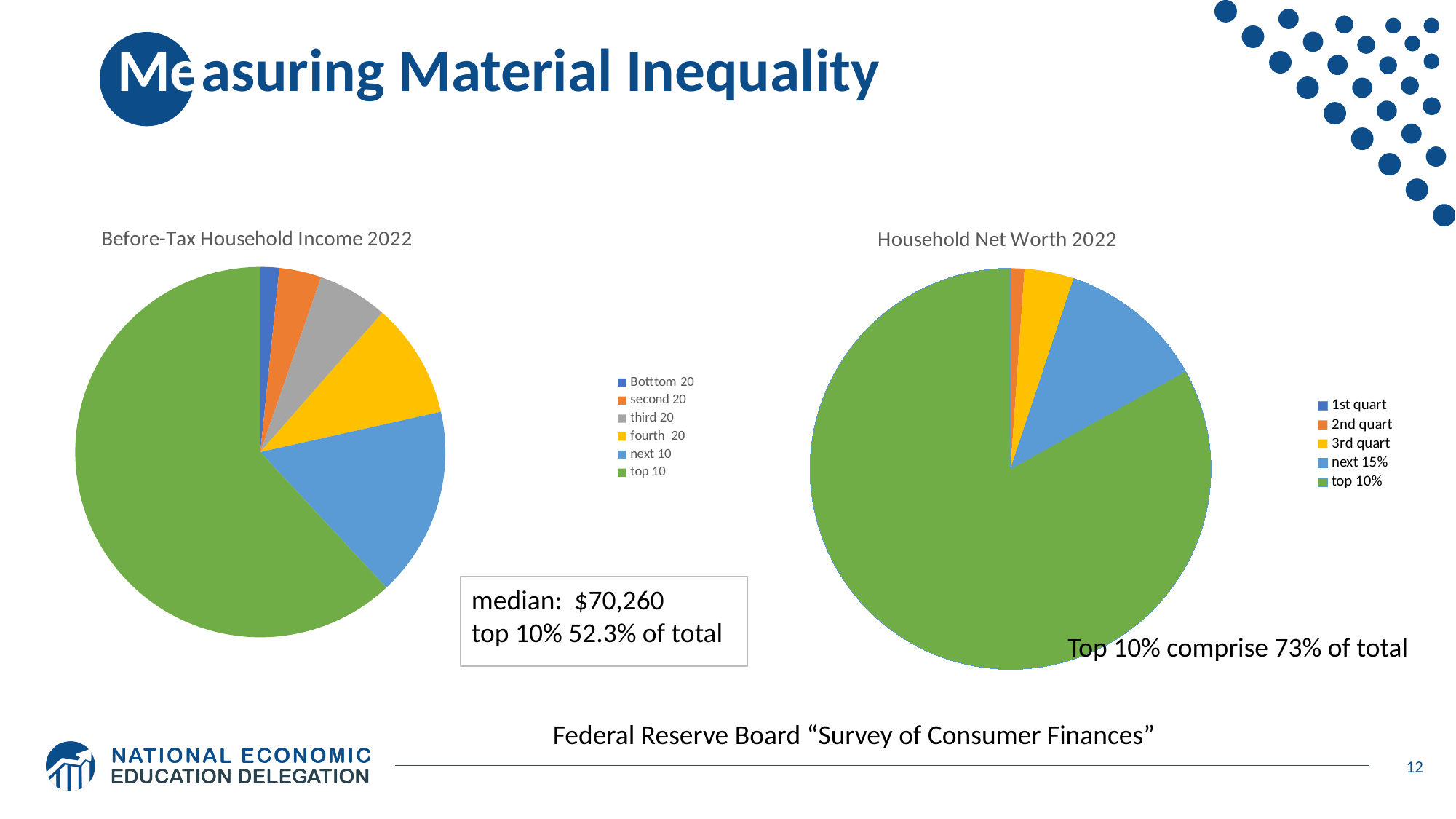
In the 'Before-Tax Household Income 2022' chart, what share of the total does the top 10% hold? 52.3% In the 'Household Net Worth 2022' chart, how many categories does the legend list? 5 In the 'Before-Tax Household Income 2022' chart, how many categories does the legend list? 6 In the 'Before-Tax Household Income 2022' chart, which slice is larger: 'fourth 20' or 'third 20'? fourth 20 What colour represents the 'top 10%' slice in the 'Household Net Worth 2022' chart? green What kind of chart is the 'Before-Tax Household Income 2022' chart? pie chart In the 'Before-Tax Household Income 2022' chart, which slice is larger: 'top 10' or 'next 10'? top 10 In the 'Household Net Worth 2022' chart, which category has the largest slice? top 10% In the 'Household Net Worth 2022' chart, what share of the total does the top 10% hold? 73% In the 'Before-Tax Household Income 2022' chart, which category has the largest slice? top 10 What is the median before-tax household income stated on the slide? $70,260 In the 'Household Net Worth 2022' chart, which slice is larger: 'next 15%' or '3rd quart'? next 15%